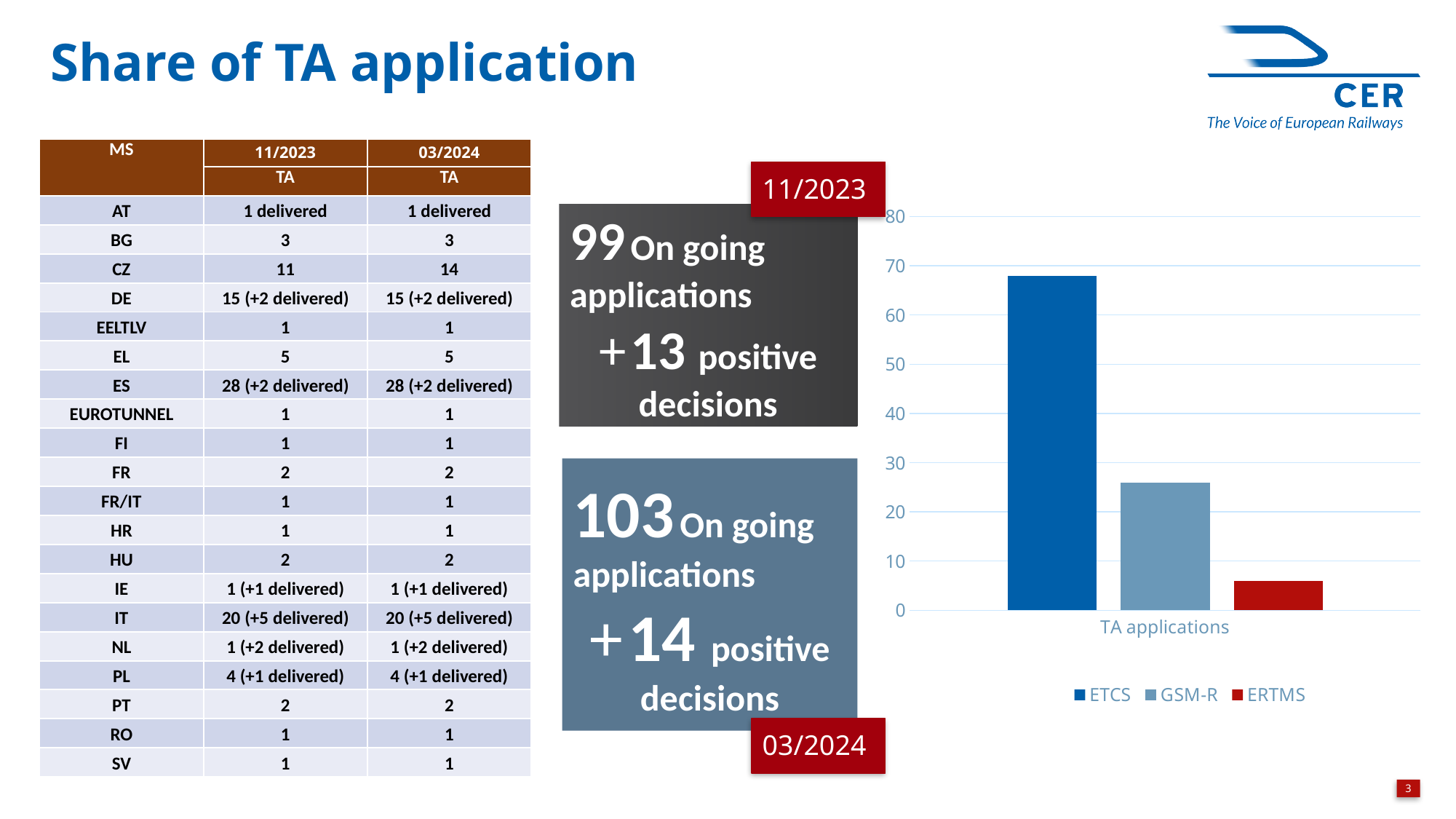
What is the category label on the x axis of the chart? TA applications Which is larger in the chart, the GSM-R bar or the ERTMS bar? GSM-R How many categories are shown on the x axis of the chart? 1 Is the value for GSM-R greater or less than 30? less Is the value for ERTMS greater or less than 10? less Is the value for ETCS greater or less than 60? greater How many series does the chart's legend list? 3 Which series has the highest bar in the chart? ETCS What colour is the ERTMS series in the chart? red Which series has the lowest bar in the chart? ERTMS What kind of chart is shown on the right of the slide? bar chart